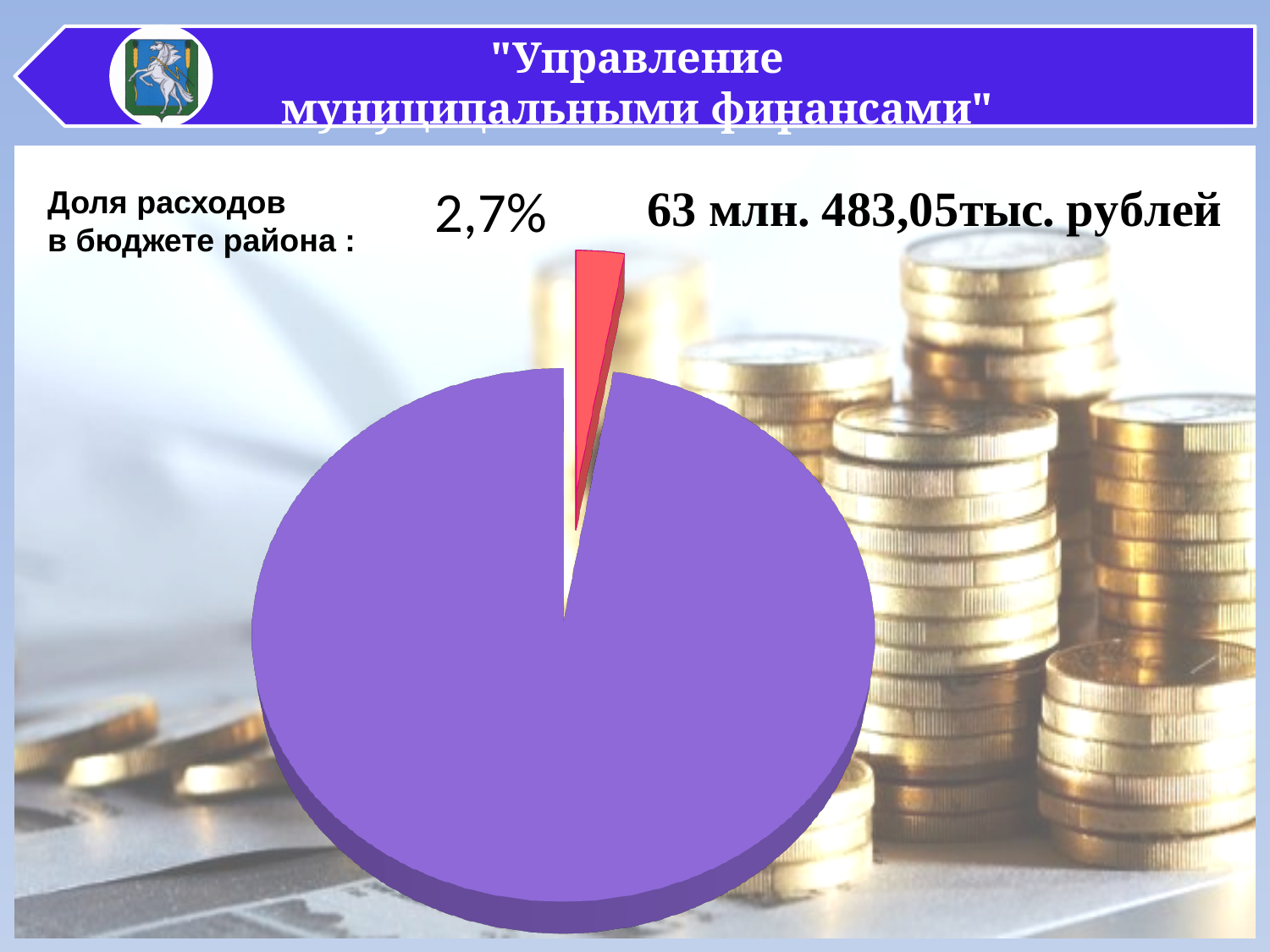
How many slices does the pie chart have? 2 What share of the district budget expenditure does the red slice of the pie chart represent? 2,7% What amount in rubles is printed at the top of the slide next to the pie chart? 63 млн. 483,05тыс. рублей What is the title shown in the header of the slide? "Управление муниципальными финансами" Is the share shown for the red slice greater or less than 5%? less Which slice of the pie chart is the smallest? the red slice (2,7%) What kind of chart is shown on the slide? pie chart Which slice of the pie chart is larger, the red one or the purple one? the purple one What is the value printed next to the pie chart for 'Доля расходов в бюджете района'? 2,7% What colour is the small slice of the pie chart? red